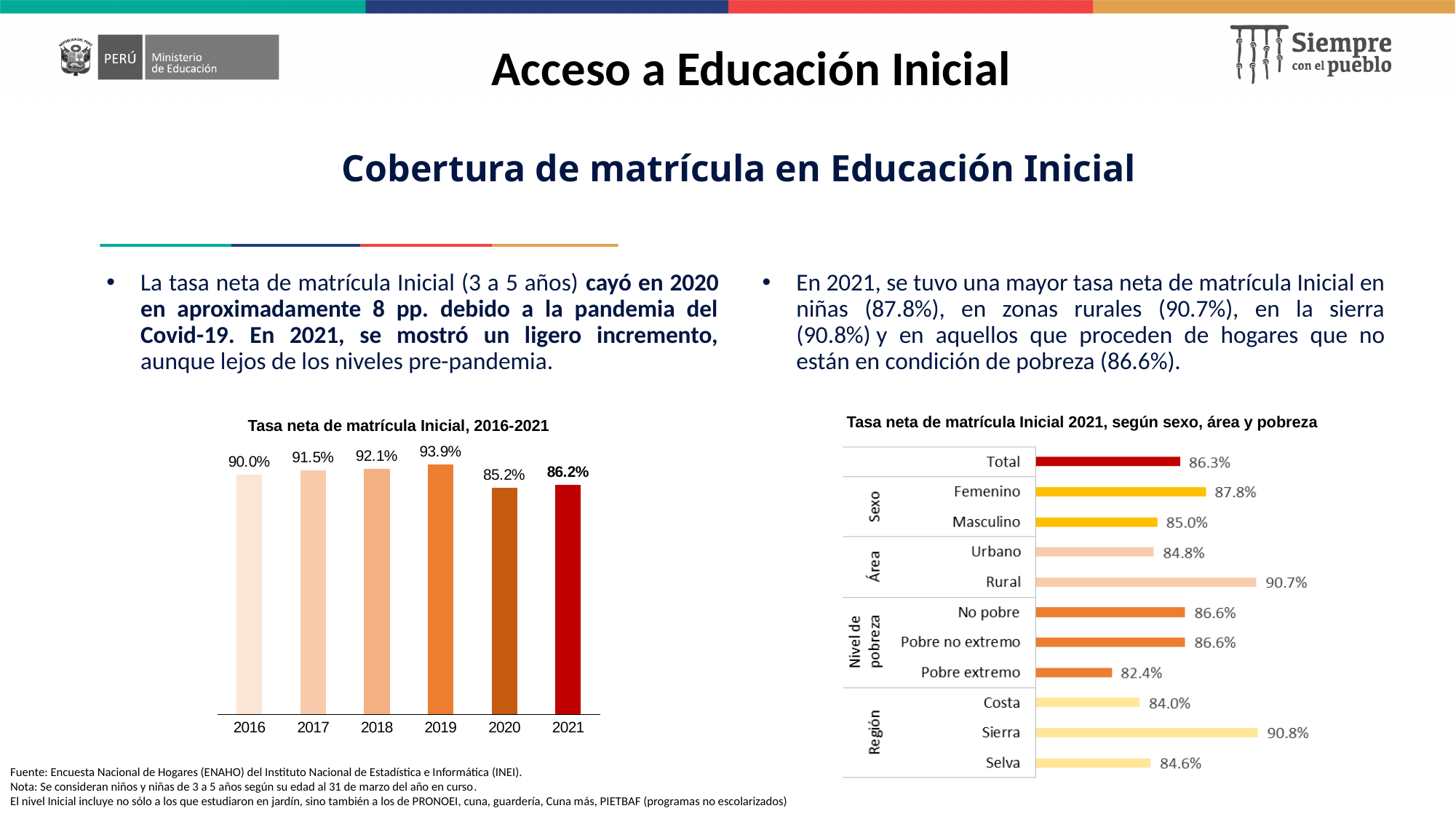
In the chart 'Tasa neta de matrícula Inicial 2021, según sexo, área y pobreza', what is the difference between Rural and Urbano? 5.9 percentage points In the chart 'Tasa neta de matrícula Inicial 2021, según sexo, área y pobreza', how many categories are plotted? 11 In the chart 'Tasa neta de matrícula Inicial, 2016-2021', what is the difference between the 2019 and 2020 values? 8.7 percentage points What kind of chart is 'Tasa neta de matrícula Inicial, 2016-2021'? Bar chart In the chart 'Tasa neta de matrícula Inicial, 2016-2021', which year has the highest value? 2019 In the chart 'Tasa neta de matrícula Inicial 2021, según sexo, área y pobreza', which is larger, Femenino or Masculino? Femenino In the chart 'Tasa neta de matrícula Inicial, 2016-2021', how many years are shown? 6 In the chart 'Tasa neta de matrícula Inicial, 2016-2021', what is the value for 2019? 93.9% In the chart 'Tasa neta de matrícula Inicial, 2016-2021', which year has the lowest value? 2020 In the chart 'Tasa neta de matrícula Inicial 2021, según sexo, área y pobreza', which category has the lowest value? Pobre extremo In the chart 'Tasa neta de matrícula Inicial 2021, según sexo, área y pobreza', what is the value for Rural? 90.7% In the chart 'Tasa neta de matrícula Inicial, 2016-2021', do the values rise or fall from 2016 to 2019? Rise